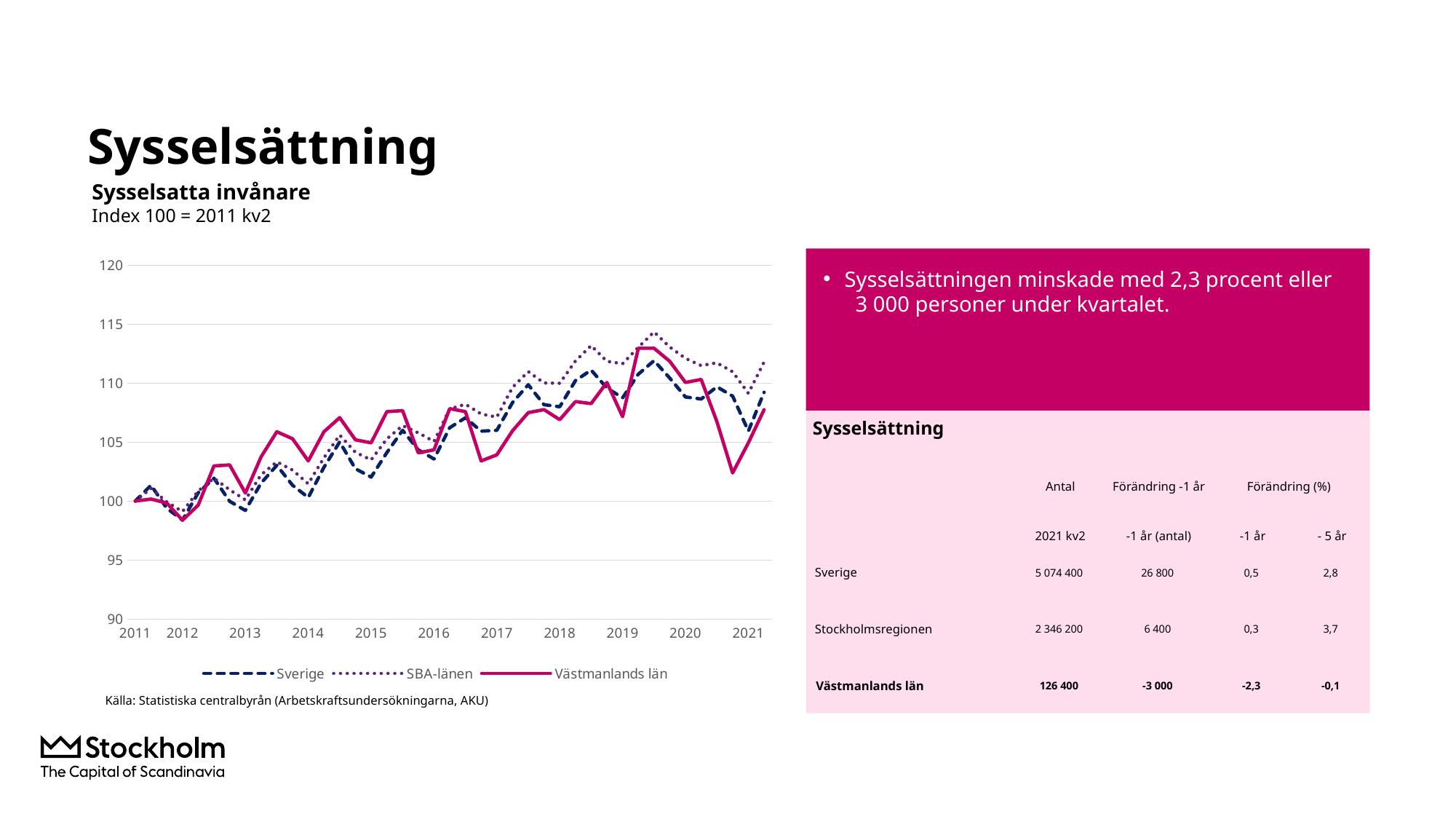
How many year labels are shown on the x axis of the chart? 11 Do the index values generally rise or fall from 2011 to 2019? rise Around 2019, which series is higher: SBA-länen or Sverige? SBA-länen Is the lowest value for Västmanlands län around 2012 greater or less than 100? less What is the title of the chart? Sysselsatta invånare Is the value for Sverige at the start of 2020 greater or less than 105? greater What kind of chart is shown on the slide? line chart Which series reaches the highest index value in the chart? SBA-länen How many series does the chart legend list? 3 Is the value for Västmanlands län at the end of the series in 2021 greater or less than 105? greater Which series are listed in the chart legend? Sverige, SBA-länen, Västmanlands län